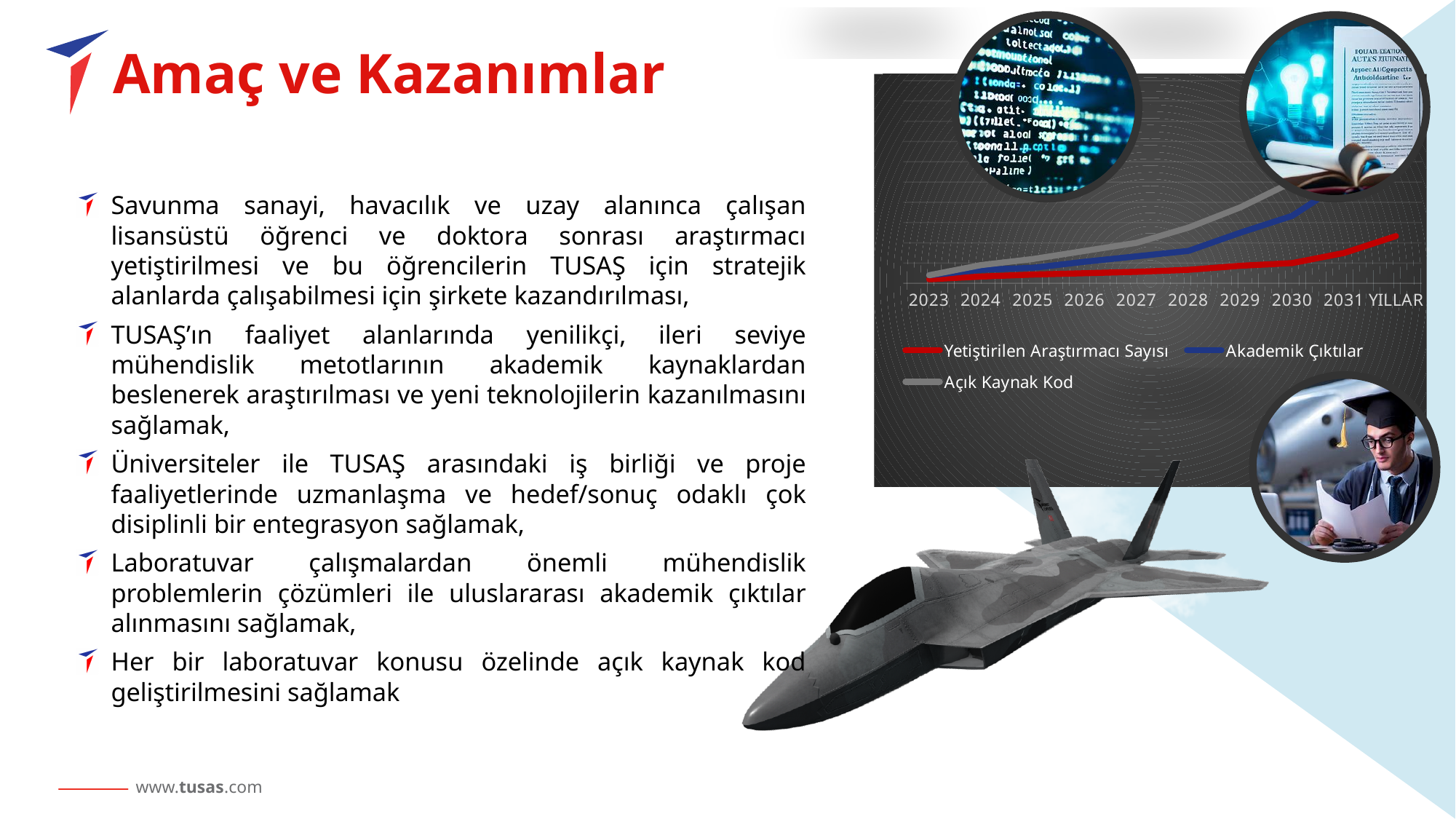
Does the Akademik Çıktılar series rise or fall across the years shown? rise What is the first year shown on the x axis of the chart? 2023 At 2030, which is larger: Akademik Çıktılar or Yetiştirilen Araştırmacı Sayısı? Akademik Çıktılar How many series does the chart's legend list? 3 At 2029, which is larger: Açık Kaynak Kod or Akademik Çıktılar? Açık Kaynak Kod Does the Açık Kaynak Kod series rise or fall across the years shown? rise What kind of chart is shown on the slide? line chart How many years are labelled along the x axis of the chart? 9 What is the last year shown on the x axis of the chart? 2031 Which series is highest at 2031? Açık Kaynak Kod Does the Yetiştirilen Araştırmacı Sayısı series rise or fall from 2023 to 2031? rise Which series is lowest at 2031? Yetiştirilen Araştırmacı Sayısı